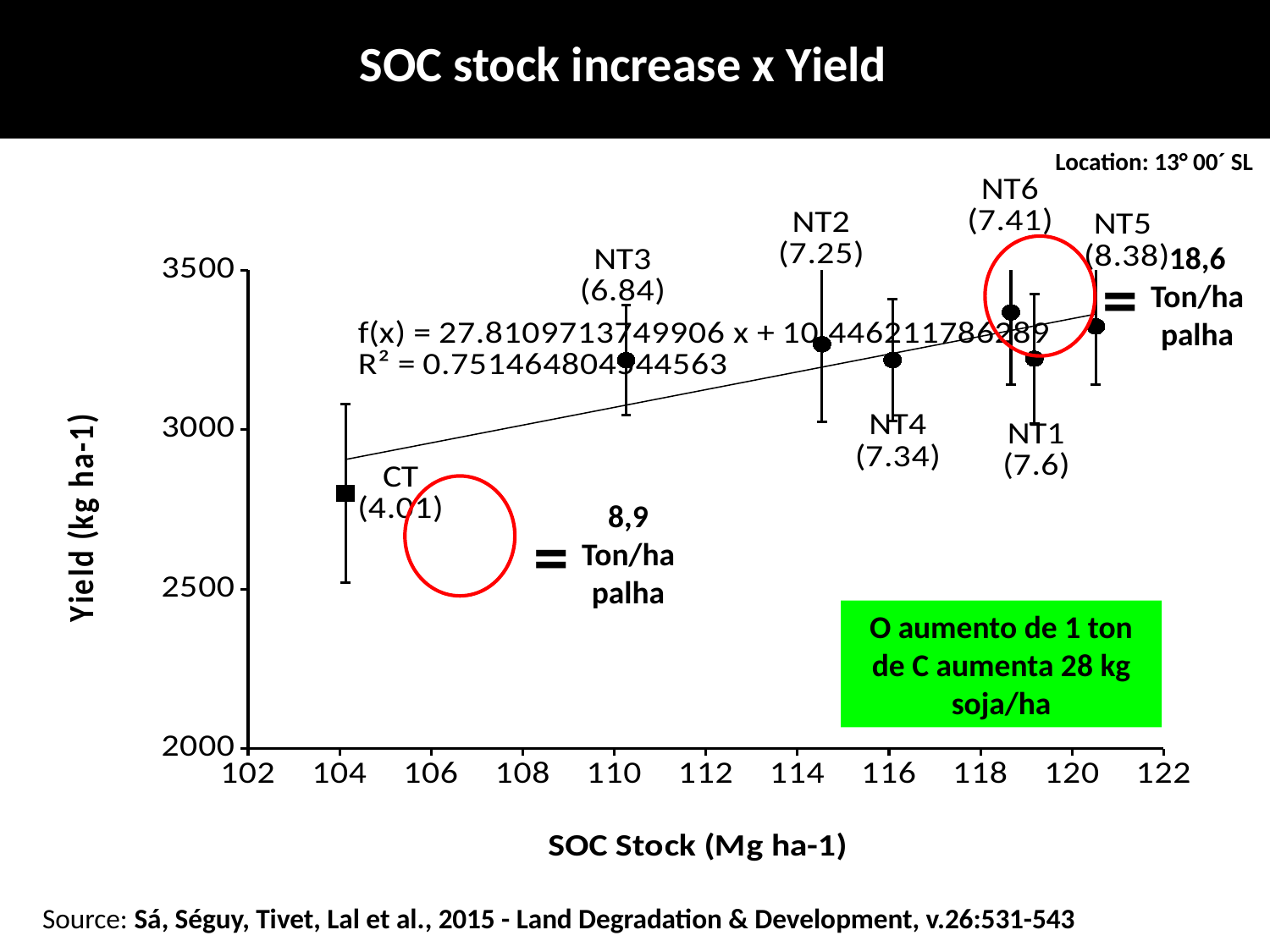
What value is printed in parentheses next to the NT3 point? 6.84 What value is printed in parentheses next to the CT point? 4.01 Which point has the lowest yield? CT Does yield rise or fall as SOC stock increases along the x axis? rise What is the label of the y axis? Yield (kg ha-1) How many data points are plotted on the chart? 7 What is the title of the chart? SOC stock increase x Yield What value is printed in parentheses next to the NT5 point? 8.38 Which point has the highest SOC stock? NT5 What kind of chart is shown on the slide? Scatter plot Is the yield for CT greater or less than 3000? less Is the SOC stock for CT greater or less than 106? less